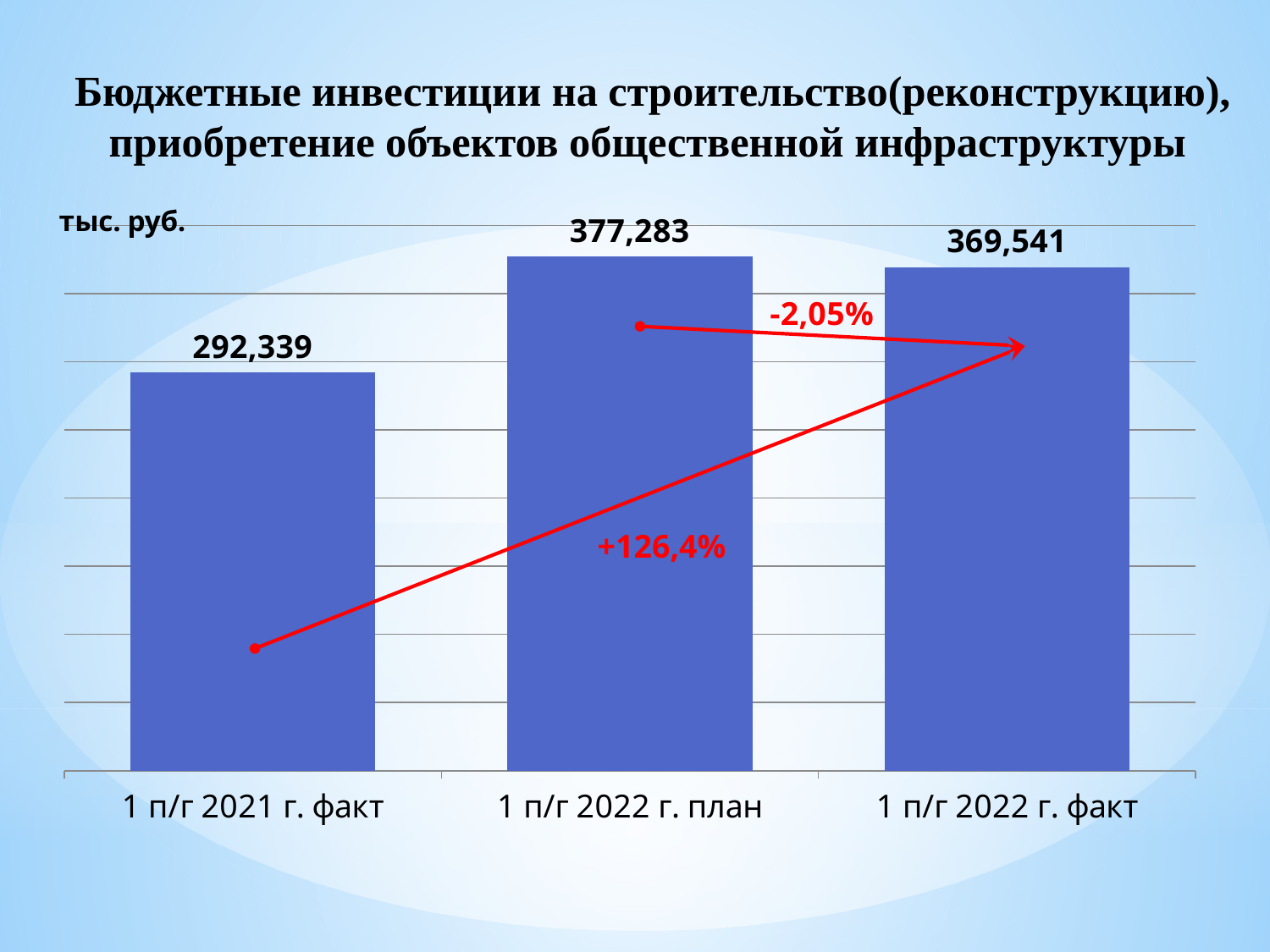
What kind of chart is shown on the slide? Bar chart What is the value for 1 п/г 2022 г. факт? 369,541 What is the difference between the values for 1 п/г 2022 г. план and 1 п/г 2022 г. факт? 7,742 Which is larger, the value for 1 п/г 2022 г. факт or the value for 1 п/г 2021 г. факт? 1 п/г 2022 г. факт What is the value for 1 п/г 2021 г. факт? 292,339 Which category has the lowest value? 1 п/г 2021 г. факт What unit of measurement is indicated on the chart? тыс. руб. What percentage change is annotated between 1 п/г 2021 г. факт and 1 п/г 2022 г. факт? +126,4% What is the value for 1 п/г 2022 г. план? 377,283 Which category has the highest value? 1 п/г 2022 г. план What is the difference between the values for 1 п/г 2022 г. план and 1 п/г 2021 г. факт? 84,944 How many categories are shown on the chart? 3